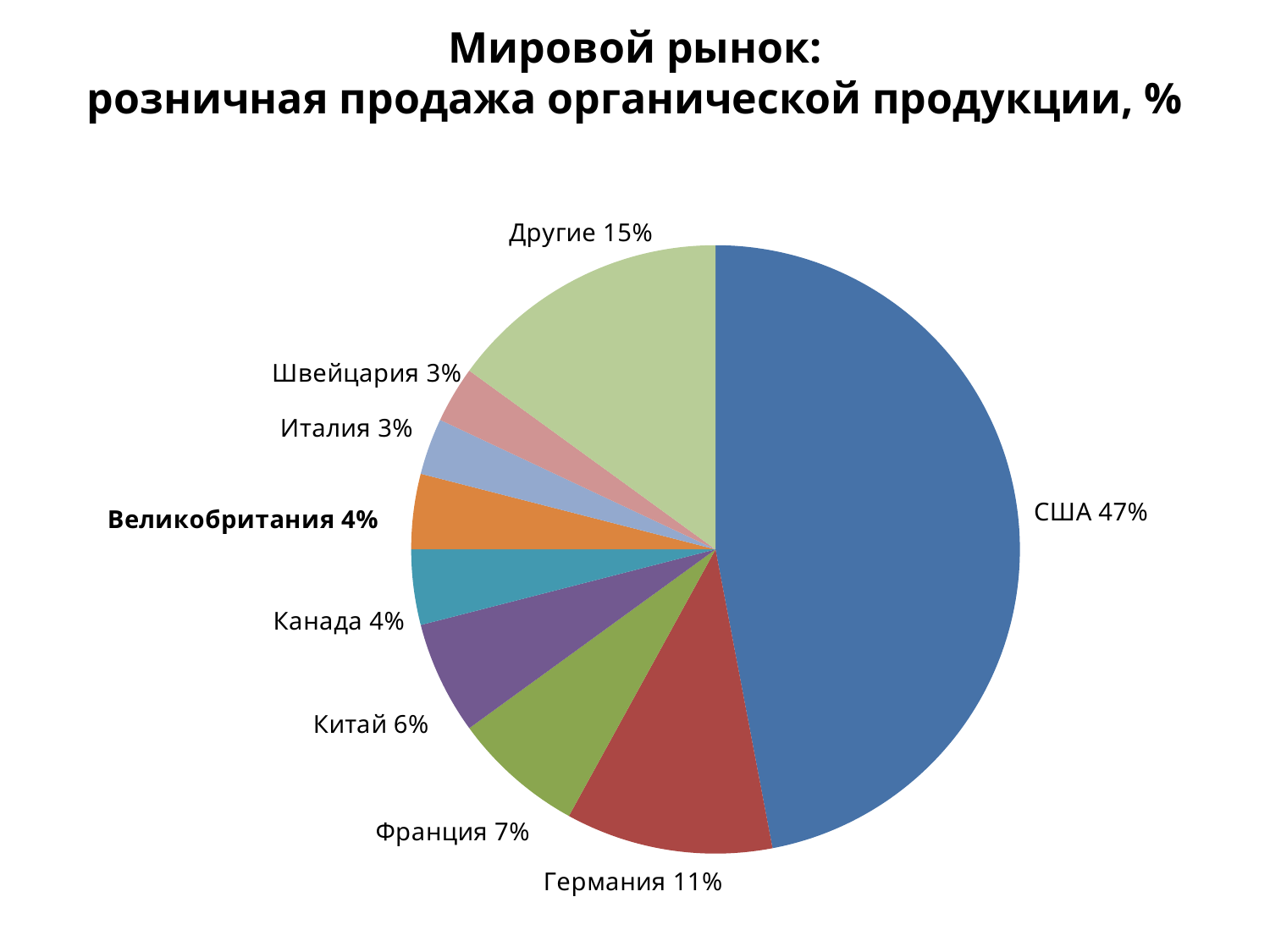
Which category has the largest slice of the pie? США What percentage is labelled for Другие (Others)? 15% Which is larger, the share for Германия or the share for Другие? Другие What type of chart is shown on the slide? Pie chart What share of the pie does США (USA) hold? 47% What is the difference between the shares of США and Германия? 36% Which category label is shown in bold on the chart? Великобритания 4% Which is larger, the share for Франция or the share for Китай? Франция What is the difference between the shares of Другие and Франция? 8% What is the value for Китай (China)? 6% How many slices does the pie chart have? 9 What is the value shown for Германия (Germany)? 11%